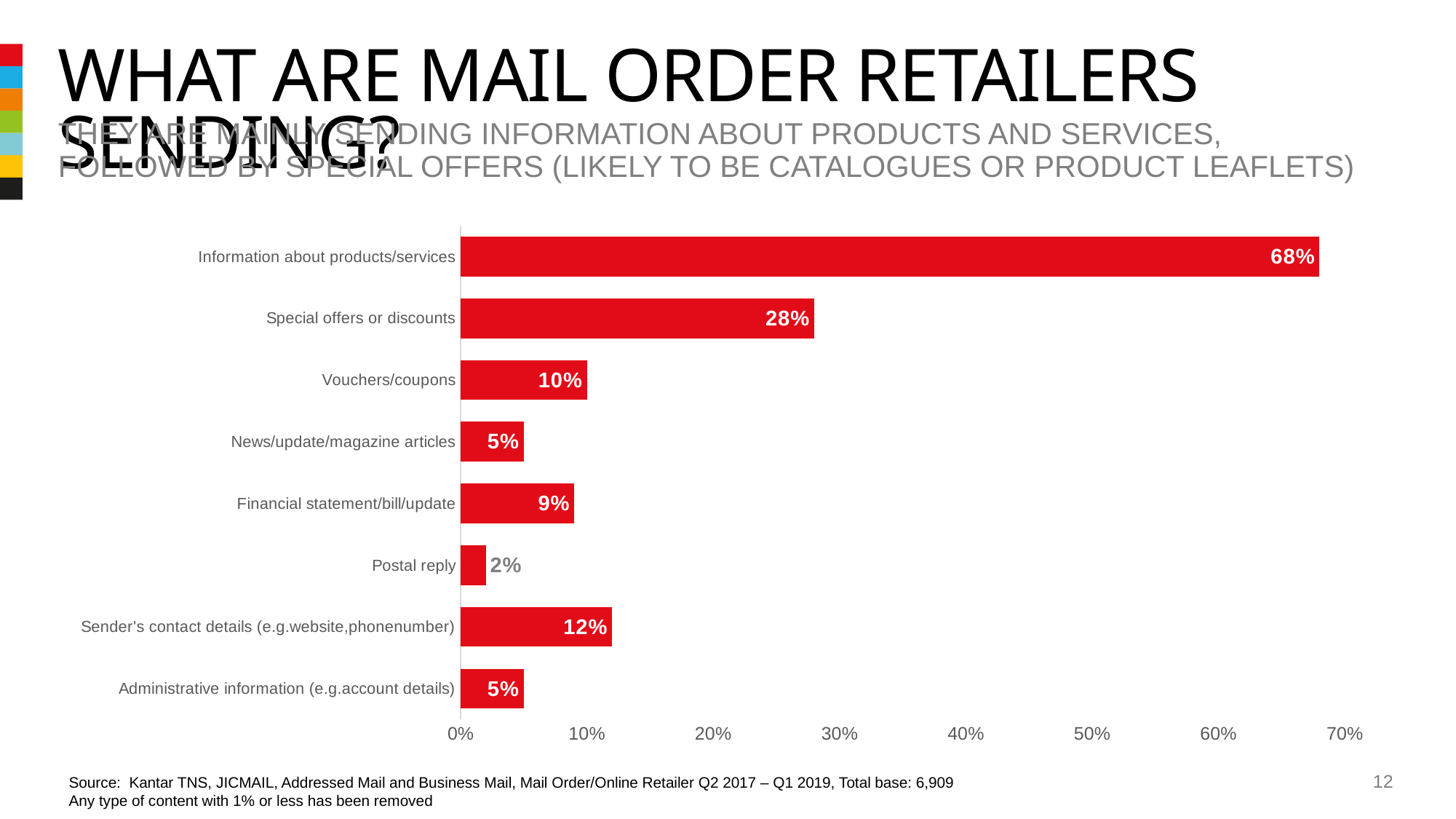
How many categories are shown in the chart? 8 What is the value for Sender's contact details (e.g.website,phonenumber)? 12% What is the difference between the values for Information about products/services and Special offers or discounts? 40% Which category has the highest value? Information about products/services Which is larger, the value for Vouchers/coupons or the value for Financial statement/bill/update? Vouchers/coupons Is the value for Special offers or discounts greater or less than 30%? less What is the value for Information about products/services? 68% What is the value for Special offers or discounts? 28% What kind of chart is shown on the slide? Bar chart What is the highest value shown on the x axis? 70% What is the value for Postal reply? 2% Which category has the lowest value? Postal reply